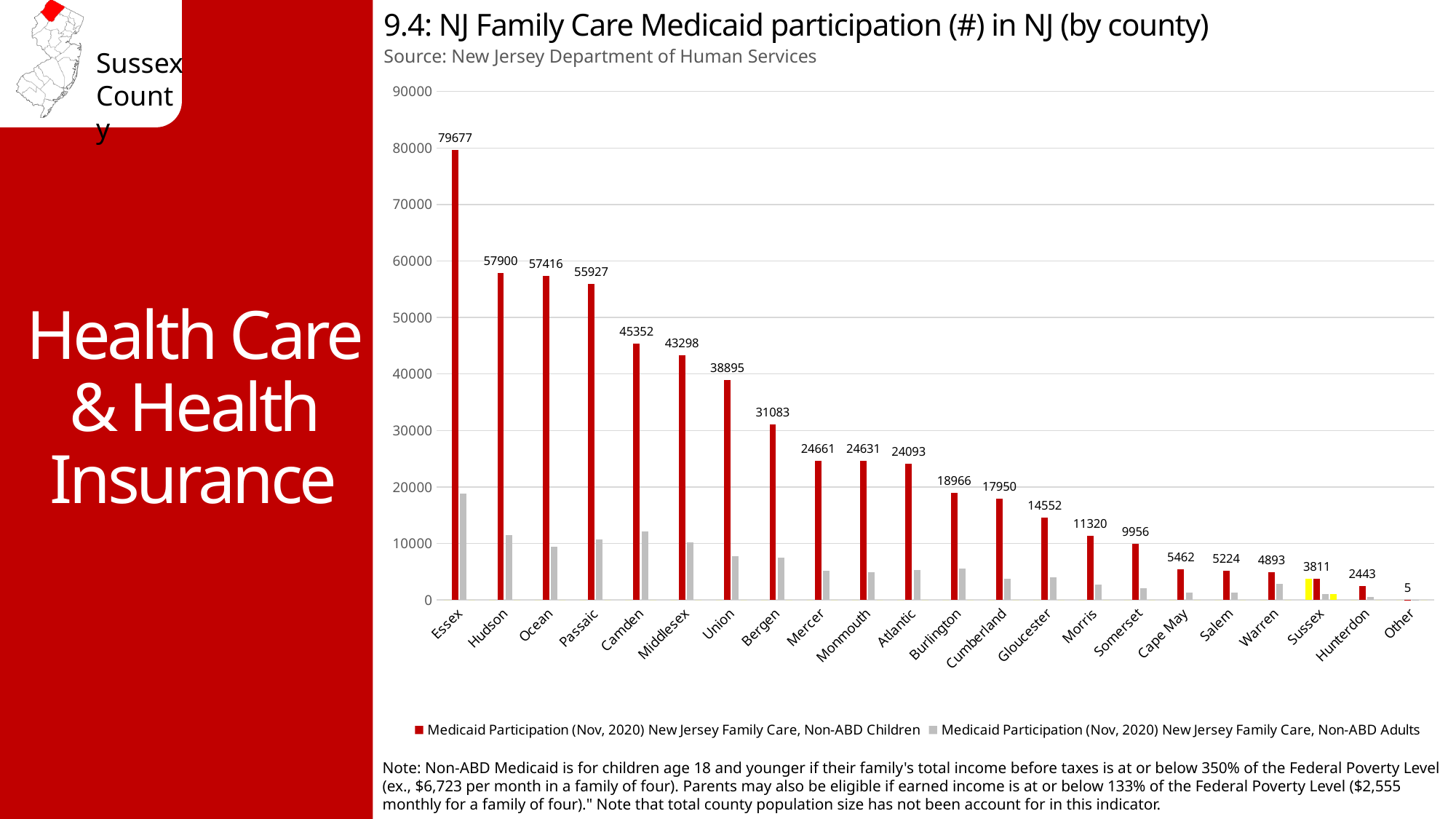
Is the Non-ABD Adults value for Essex greater or less than 10000? greater What is the difference between the Non-ABD Children values for Hudson and Ocean? 484 What is the Non-ABD Children Medicaid participation value for Essex? 79677 Which category has the highest Non-ABD Children Medicaid participation? Essex What is the Non-ABD Children Medicaid participation value for Sussex? 3811 How many series does the legend list? 2 What is the Non-ABD Children Medicaid participation value for Cumberland? 17950 What is the difference between the Non-ABD Children values for Sussex and Hunterdon? 1368 What kind of chart is shown on the slide? bar chart How many categories are shown on the x axis? 22 Which has a larger Non-ABD Children value, Camden or Middlesex? Camden Which category has the lowest Non-ABD Children Medicaid participation? Other